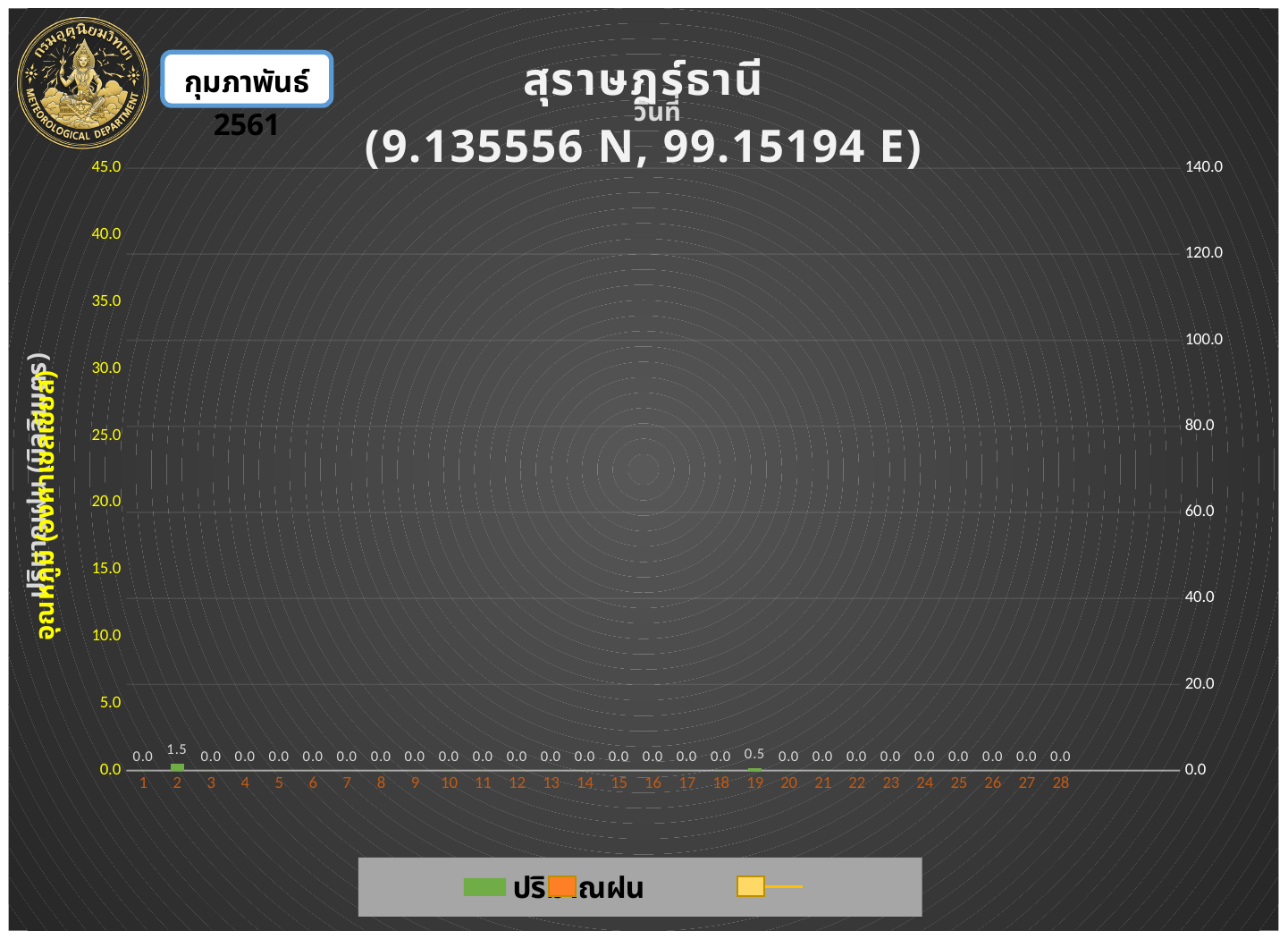
What kind of chart is used to show the rainfall values? bar chart Which day has the highest rainfall value? 2 Is the rainfall value for day 2 greater or less than 5.0 on the left axis? less What is the highest tick value on the left vertical axis? 45.0 Which has the larger rainfall value, day 2 or day 19? day 2 How many days have a rainfall value other than 0.0? 2 What is the rainfall value shown for day 19? 0.5 What is the rainfall value shown for day 1? 0.0 What is the rainfall value shown for day 2? 1.5 What is the highest tick value on the right vertical axis? 140.0 What is the difference between the rainfall values for day 2 and day 19? 1.0 How many days are shown on the x axis? 28